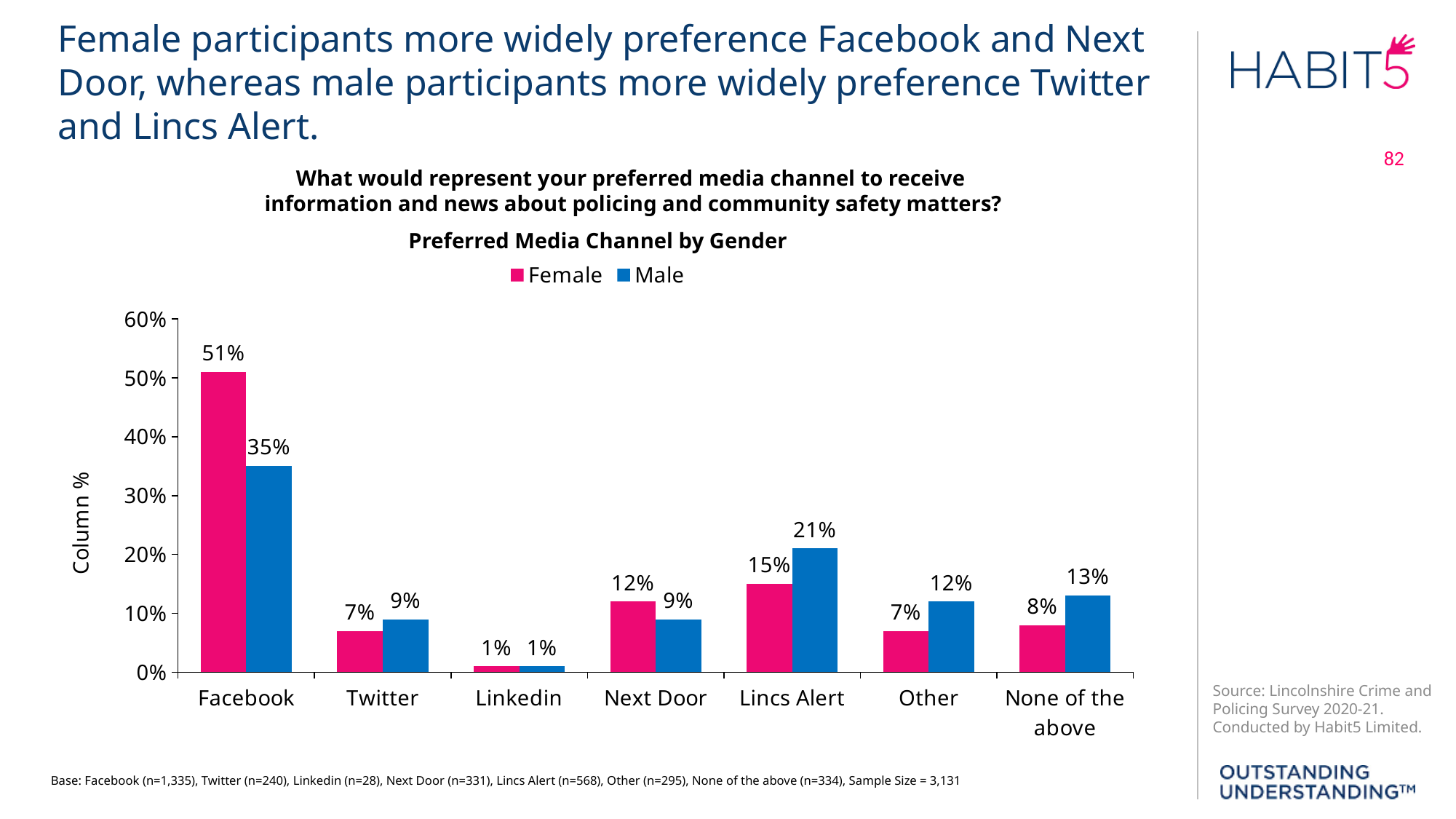
What is the difference between the Female and Male values for Facebook? 16% What is the Female value for Facebook? 51% How many series does the legend list? 2 What is the Male value for Lincs Alert? 21% What is the Male value for None of the above? 13% Which is larger for Next Door, the Female value or the Male value? Female How many categories are shown on the x axis? 7 What kind of chart is shown? Bar chart Which category has the highest Female value? Facebook What is the title of the chart? Preferred Media Channel by Gender Which category has the lowest Male value? Linkedin Which is larger for Twitter, the Female value or the Male value? Male